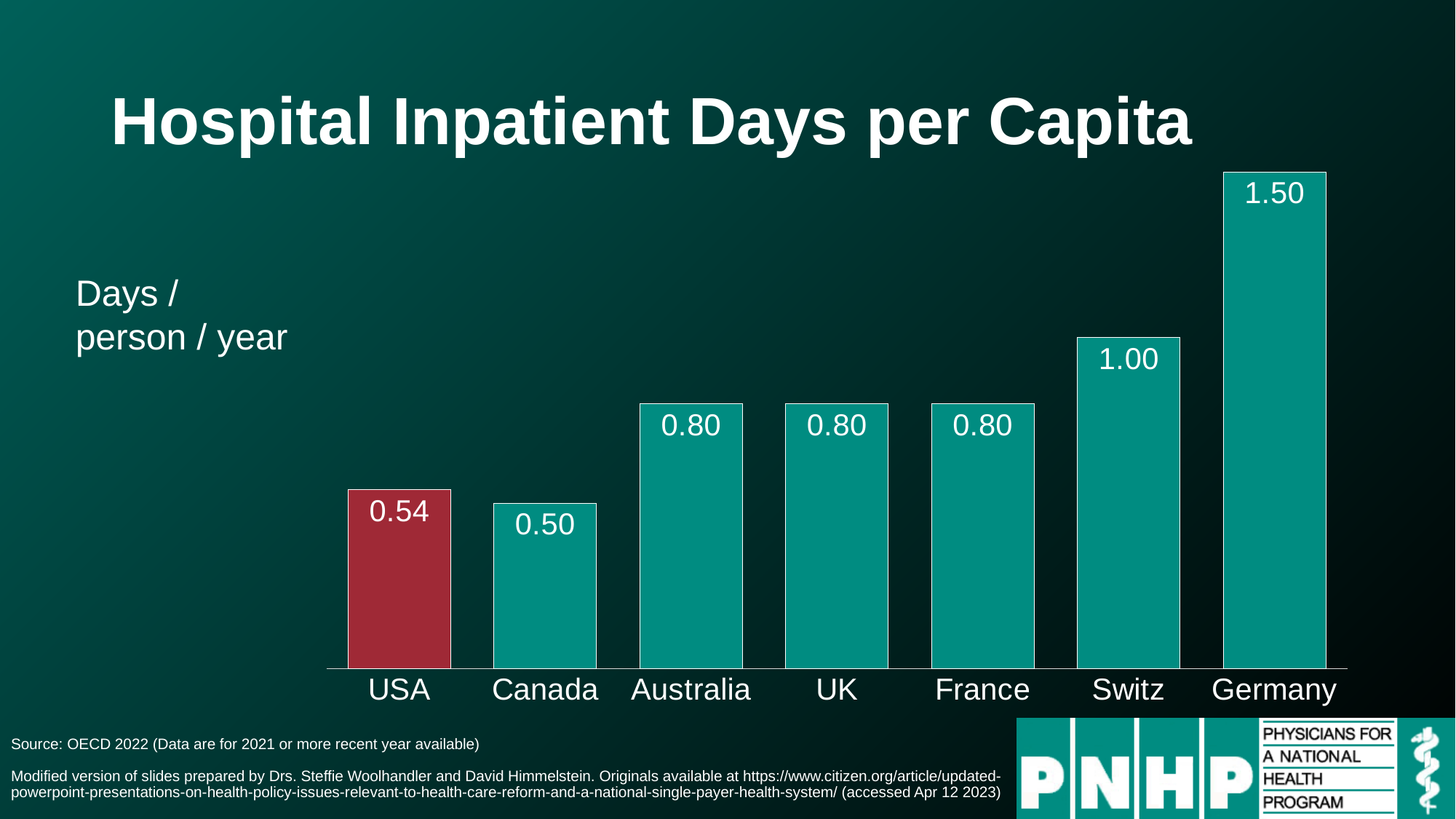
How many countries are shown in the chart? 7 What is the value for Switz? 1.00 Which country has the lowest hospital inpatient days per capita? Canada What is the value for the USA? 0.54 What is the difference between the values for Switz and Canada? 0.50 Which country's bar is coloured differently (red) from the others? USA What is the title of the chart? Hospital Inpatient Days per Capita What kind of chart is shown on the slide? Bar chart Which country has the highest hospital inpatient days per capita? Germany What is the difference between the values for Germany and the USA? 0.96 What is the value for Germany? 1.50 Which is larger, the value for the USA or the value for Canada? USA